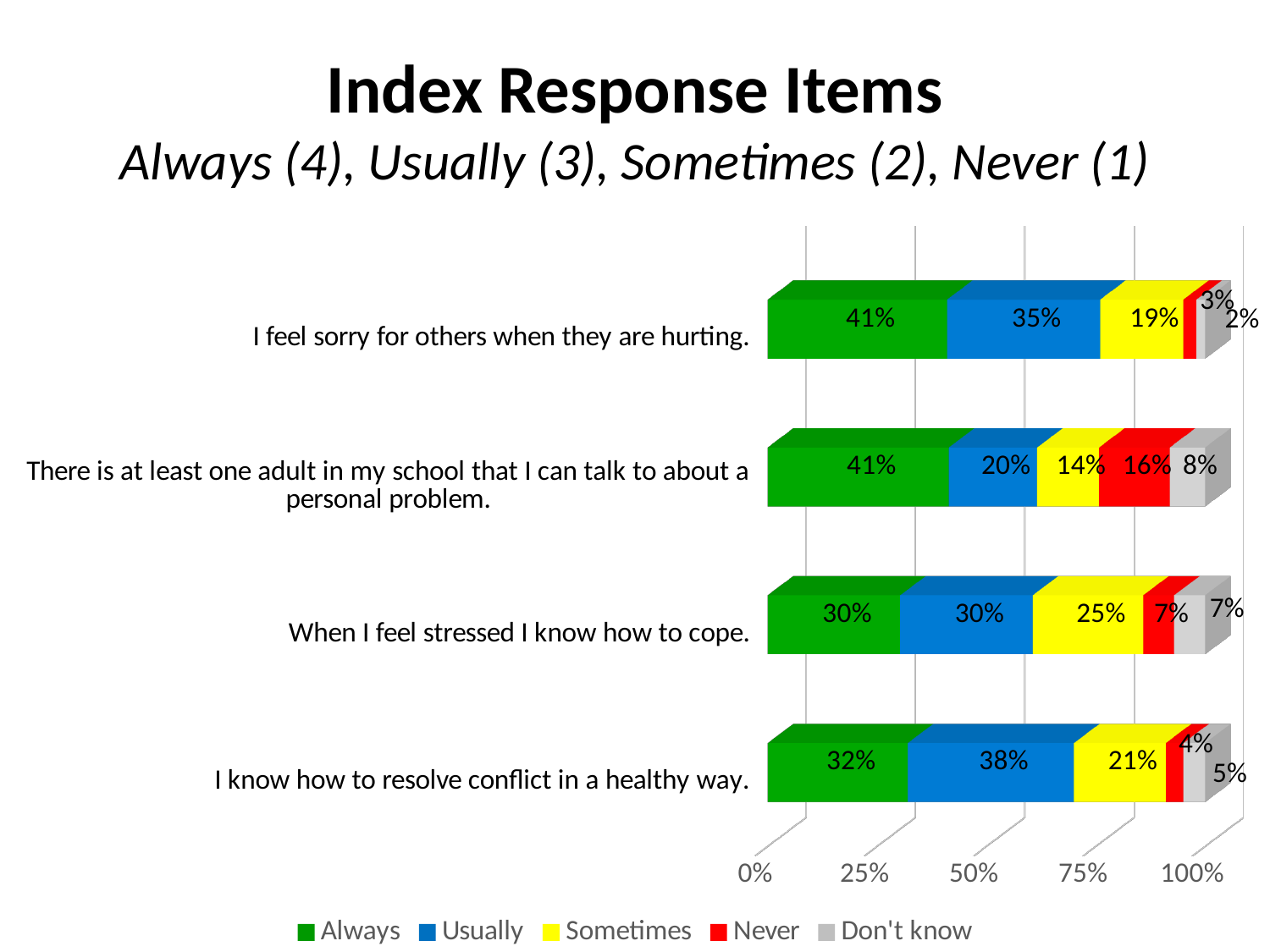
Which response item has the lowest 'Always' percentage? When I feel stressed I know how to cope. Which is larger: the 'Don't know' percentage for 'When I feel stressed I know how to cope.' or for 'I know how to resolve conflict in a healthy way.'? When I feel stressed I know how to cope. How many response items (categories) are plotted in the chart? 4 What percentage answered 'Sometimes' to 'When I feel stressed I know how to cope.'? 25% How many series does the legend list? 5 What kind of chart is shown on the slide? Stacked bar chart What is the difference between the 'Usually' percentages for 'I feel sorry for others when they are hurting.' and 'There is at least one adult in my school that I can talk to about a personal problem.'? 15% What percentage answered 'Always' to 'I feel sorry for others when they are hurting.'? 41% Which response item has the highest 'Never' percentage? There is at least one adult in my school that I can talk to about a personal problem. What colour represents the 'Sometimes' series in the chart? Yellow What percentage answered 'Never' to 'There is at least one adult in my school that I can talk to about a personal problem.'? 16% What percentage answered 'Usually' to 'I know how to resolve conflict in a healthy way.'? 38%